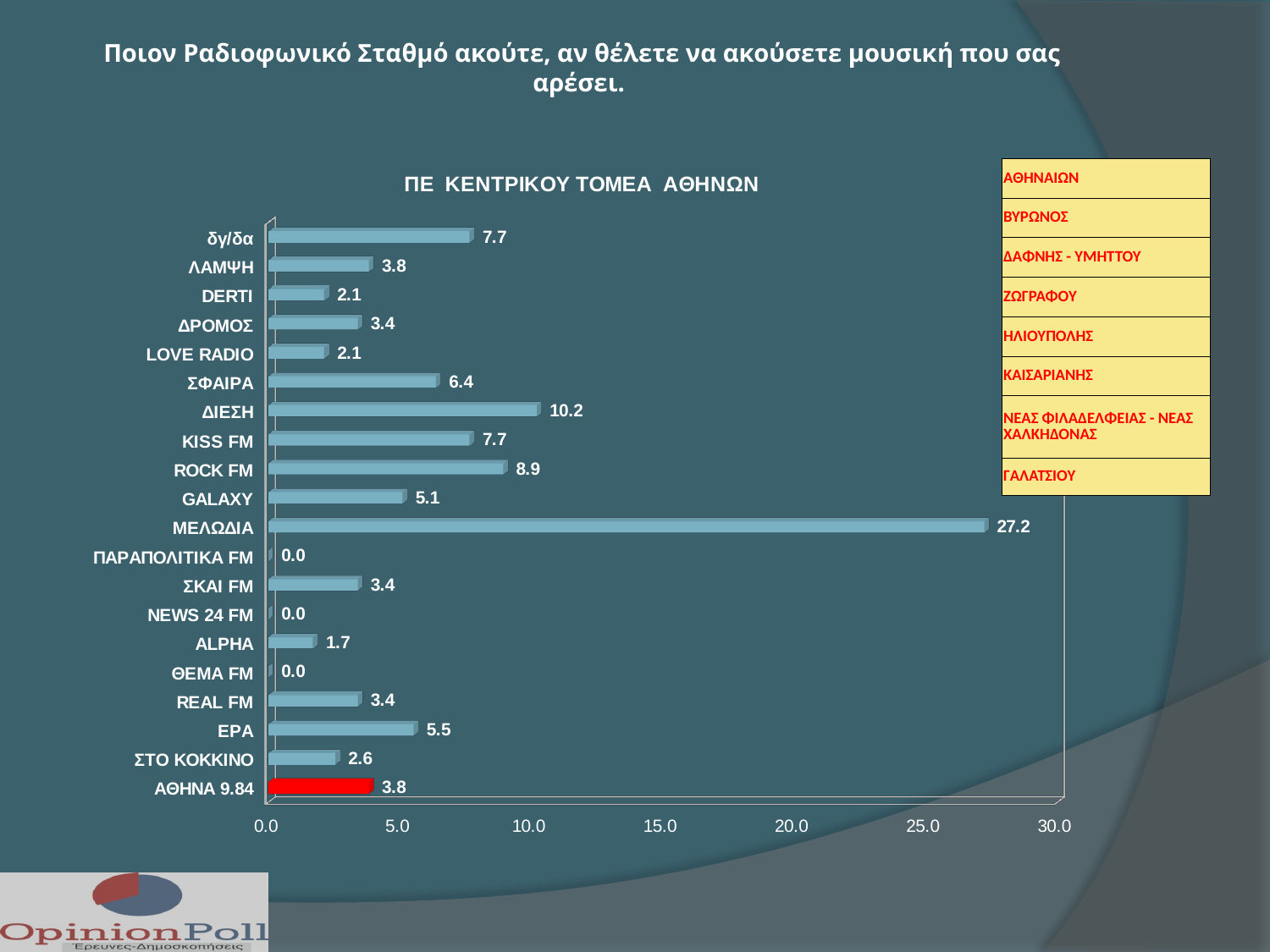
What is the value for ΔΙΕΣΗ? 10.2 What kind of chart is shown on the slide? Bar chart How many radio stations are listed on the chart? 20 Which radio station's bar is coloured red? ΑΘΗΝΑ 9.84 What is the value for ROCK FM? 8.9 How many radio stations have a value of 0.0? 3 Which has a larger value, ΣΦΑΙΡΑ or ΕΡΑ? ΣΦΑΙΡΑ Which radio station has the highest value? ΜΕΛΩΔΙΑ What is the difference between the values for ROCK FM and KISS FM? 1.2 What is the value for ΑΘΗΝΑ 9.84? 3.8 What is the difference between the values for ΜΕΛΩΔΙΑ and ΔΙΕΣΗ? 17.0 What is the value for ΜΕΛΩΔΙΑ? 27.2